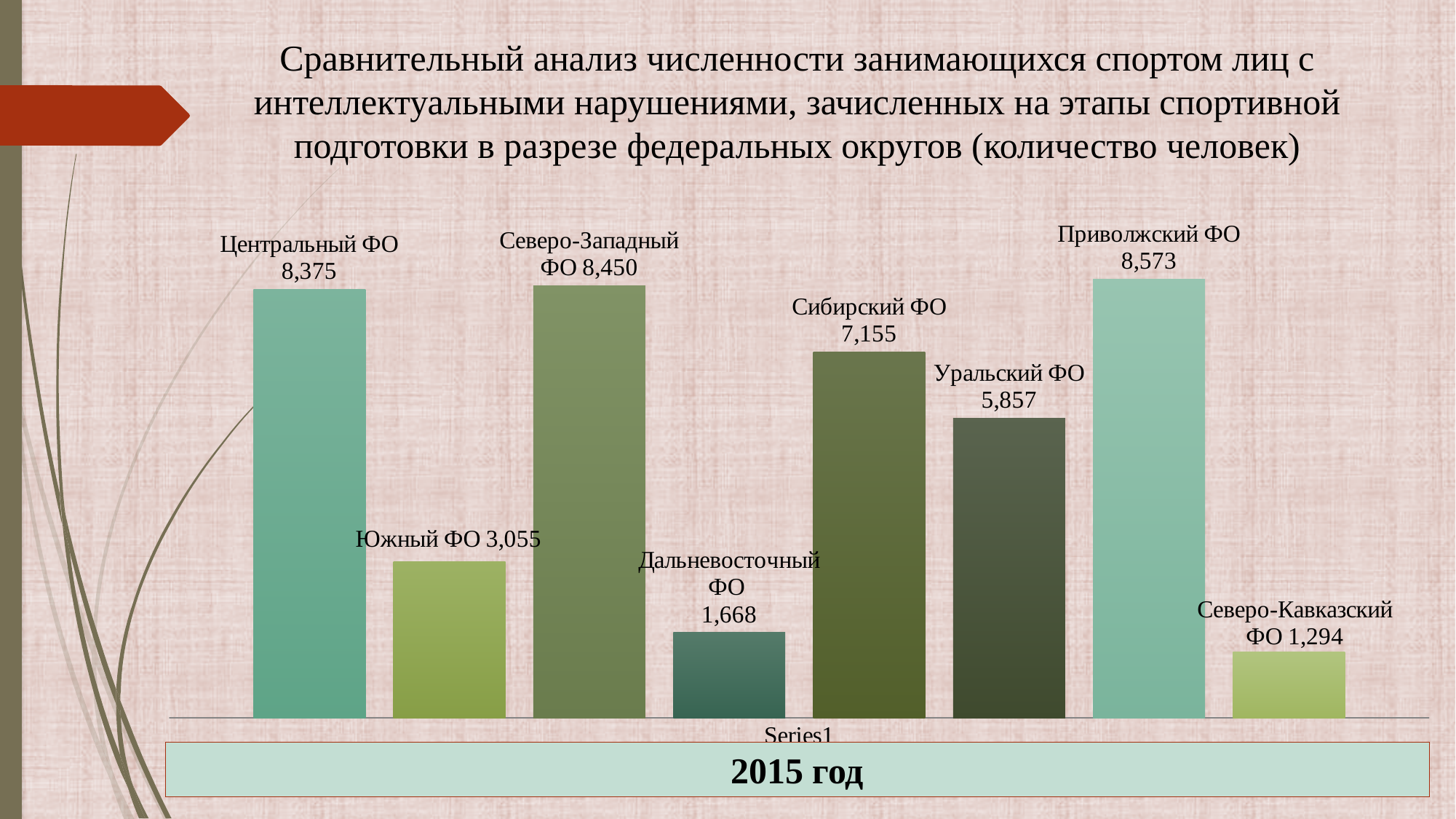
Which year does the chart refer to, according to the label below the chart? 2015 год What is the difference between the values for Сибирский ФО and Уральский ФО? 1,298 How many federal districts (bars) are shown in the chart? 8 Which federal district has the lowest value? Северо-Кавказский ФО Which is larger, the value for Южный ФО or the value for Уральский ФО? Уральский ФО What is the value for Сибирский ФО? 7,155 What is the difference between the values for Южный ФО and Дальневосточный ФО? 1,387 What is the value for Центральный ФО? 8,375 Which federal district has the highest value? Приволжский ФО What is the value for Дальневосточный ФО? 1,668 What is the value for Уральский ФО? 5,857 What type of chart is shown on the slide? bar chart